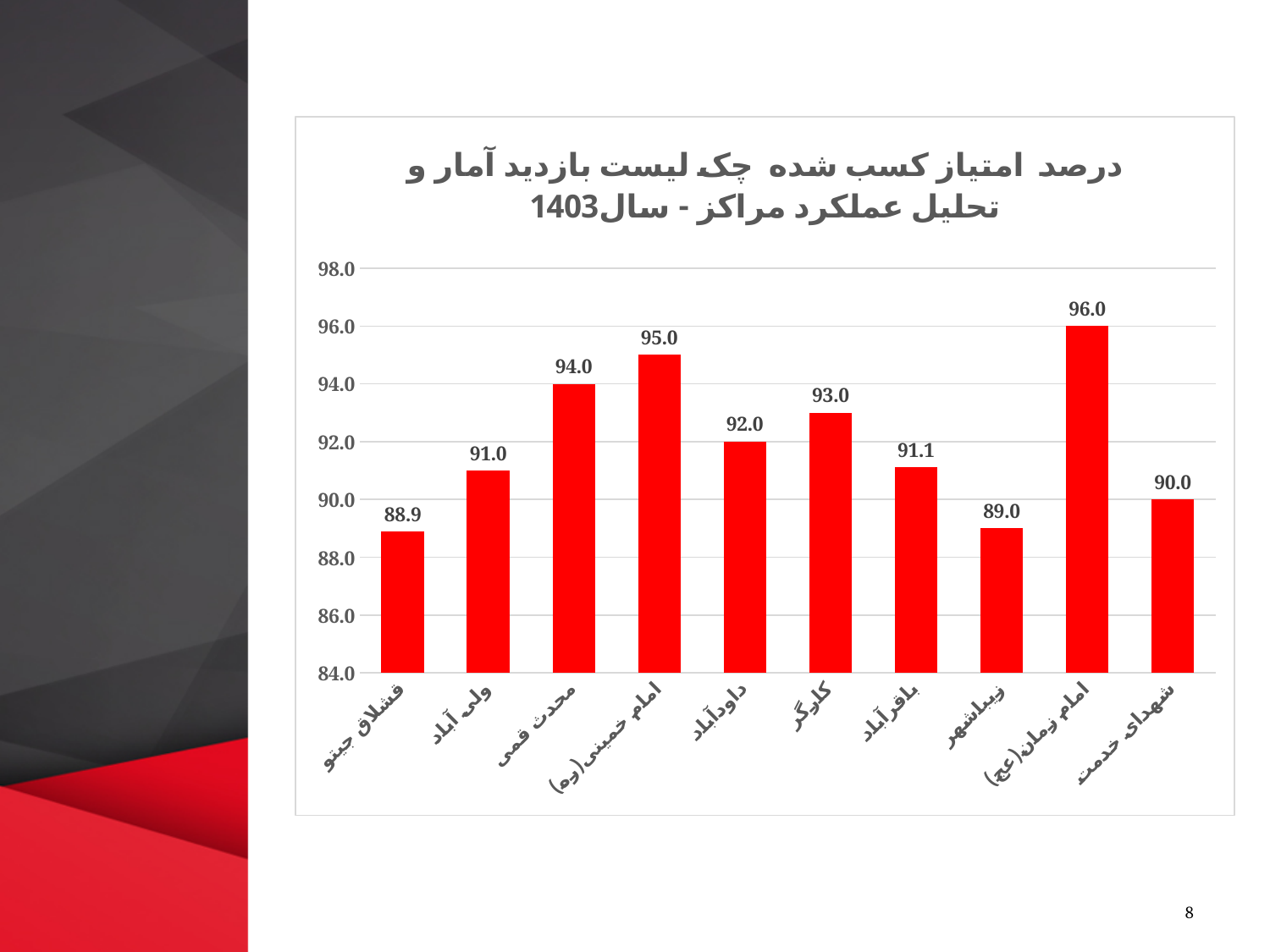
Which centre has the lowest value? قشلاق جیتو What is the value for باقرآباد? 91.1 Is the value for محدث قمی greater or less than 92.0? greater How many centres (categories) are plotted in the chart? 10 Which is larger, the value for کارگر or the value for داودآباد? کارگر What type of chart is shown on the slide? bar chart What is the difference between the values for ولی آباد and شهدای خدمت? 1.0 What is the difference between the values for امام زمان(عج) and زیباشهر? 7.0 What is the value for امام خمینی(ره)? 95.0 What colour are the bars in the chart? red Which centre has the highest value? امام زمان(عج)